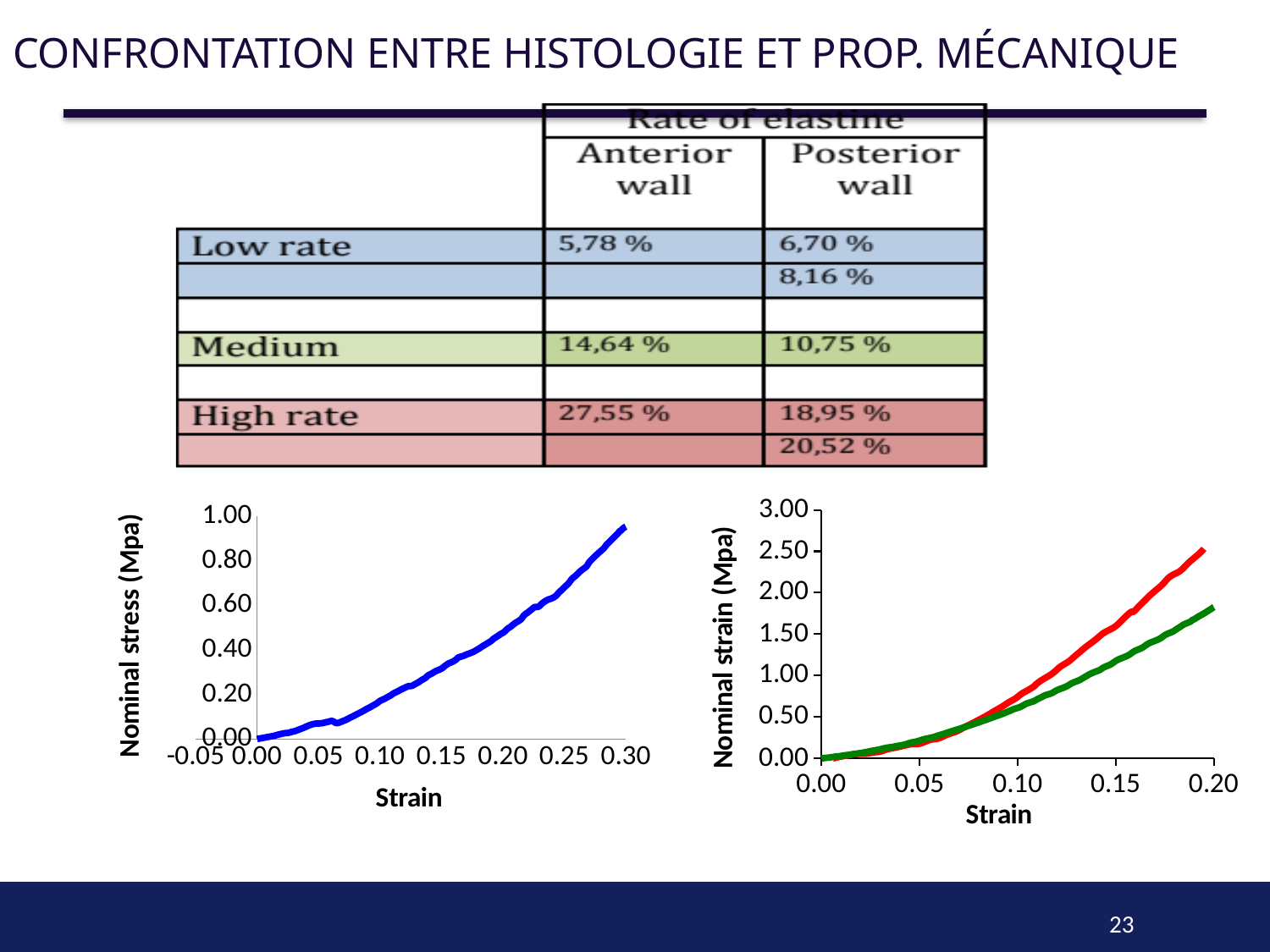
How many lines are plotted in the right chart? 2 In the right chart, is the value of the green line at a strain of 0.20 greater or less than 2.00? less In the left chart, is the nominal stress at a strain of 0.05 greater or less than 0.20? less In the left chart, does the nominal stress rise or fall as strain increases? rise What is the x-axis title of the left chart? Strain What kind of chart is the right chart with the red and green lines? line chart How many lines are plotted in the left chart? 1 In the right chart, do the red and green lines rise or fall as strain increases? rise In the right chart, is the value of the red line at a strain of 0.20 greater or less than 2.00? greater What kind of chart is the left chart with the blue line? line chart In the right chart, which line is higher at a strain of 0.20, the red line or the green line? red line